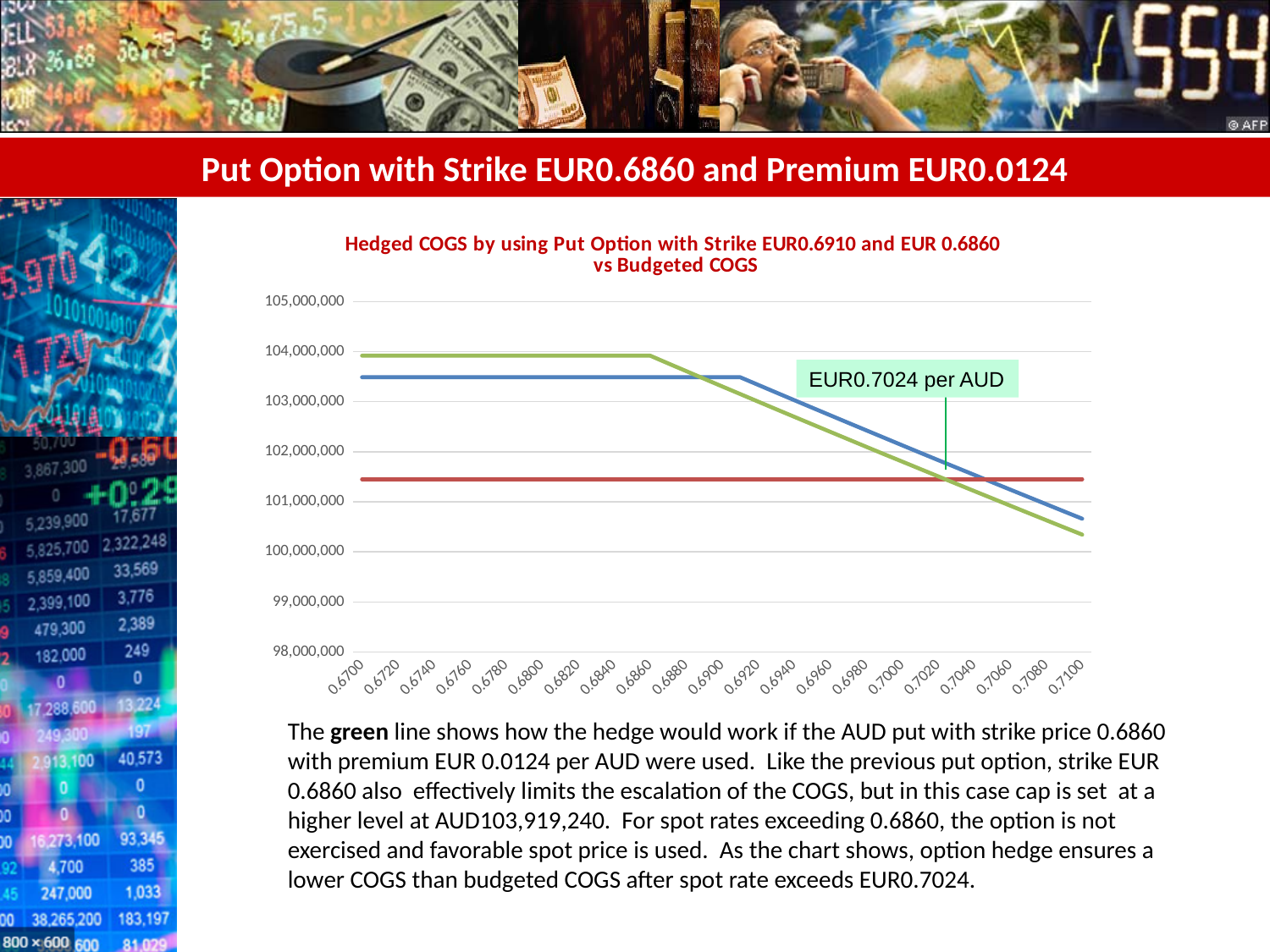
What is the highest value shown on the y axis of the chart? 105,000,000 Does the green line rise or fall between 0.6860 and 0.7100? fall How many tick labels are shown on the x axis of the chart? 21 Is the value of the red line greater or less than 102,000,000? less Is the value of the blue line at 0.6700 greater or less than 104,000,000? less What type of chart is shown on the slide? line chart Is the value of the green line at 0.6700 greater or less than 103,000,000? greater What is the title of the chart? Hedged COGS by using Put Option with Strike EUR0.6910 and EUR 0.6860 vs Budgeted COGS How many lines are plotted on the chart? 3 At 0.6700, which line is higher, the green line or the blue line? green line At 0.7100, which line is higher, the blue line or the green line? blue line